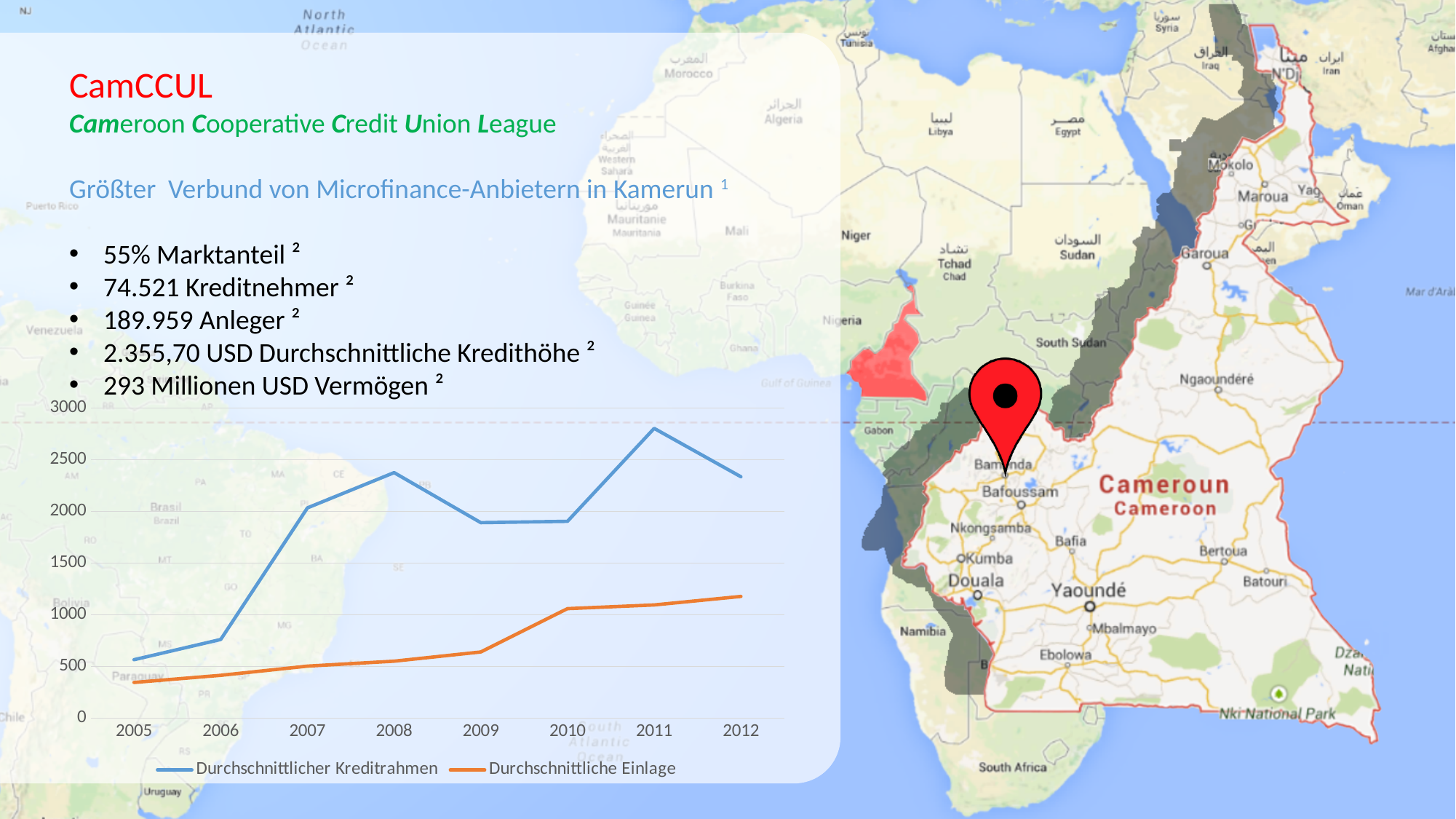
In which year is the value for Durchschnittliche Einlage lowest? 2005 Which series has the larger value in 2008, Durchschnittlicher Kreditrahmen or Durchschnittliche Einlage? Durchschnittlicher Kreditrahmen In which year is the value for Durchschnittlicher Kreditrahmen highest? 2011 In which year is the value for Durchschnittlicher Kreditrahmen lowest? 2005 Does the value for Durchschnittliche Einlage rise or fall from 2005 to 2012? rise In which year is the value for Durchschnittliche Einlage highest? 2012 Is the value for Durchschnittlicher Kreditrahmen in 2011 greater or less than 2500? greater How many series does the chart legend list? 2 How many years are shown on the x axis of the chart? 8 Is the value for Durchschnittlicher Kreditrahmen in 2005 greater or less than 1000? less What kind of chart is shown on the slide? line chart Is the value for Durchschnittliche Einlage in 2009 greater or less than 1000? less